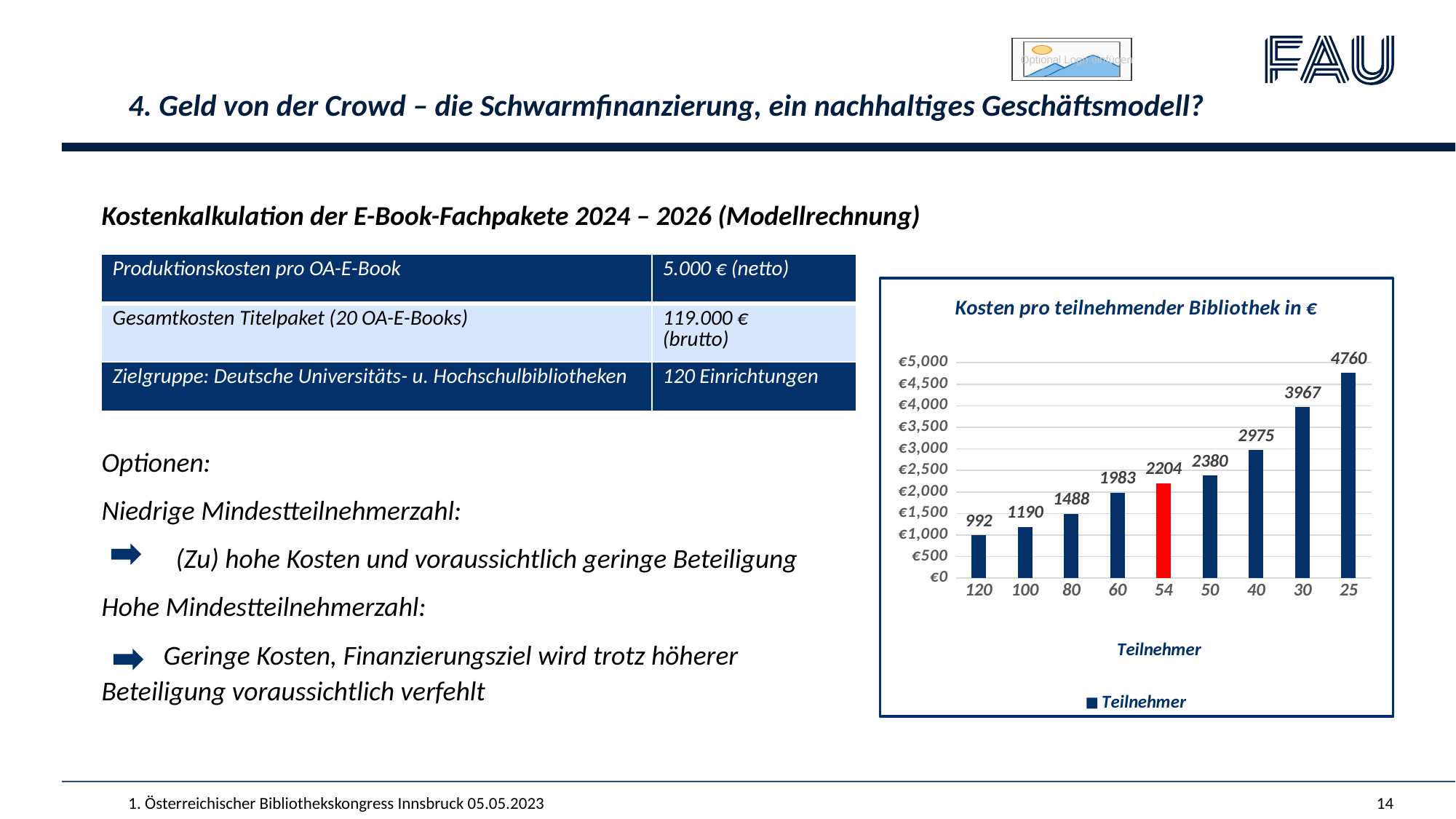
Which participant count has the highest cost per library? 25 What is the cost per participating library when there are 25 participants? 4760 Which participant count has the lowest cost per library? 120 How many participant categories are shown on the x axis? 9 Which bar in the chart is highlighted in red? 54 What is the cost per participating library when there are 54 participants (Teilnehmer)? 2204 What kind of chart is shown on the slide? bar chart Which has a higher cost per library: 60 participants or 80 participants? 60 What is the cost per participating library when there are 120 participants? 992 How many series does the legend list? 1 What is the difference in cost per library between 30 participants and 40 participants? 992 Do the costs per library rise or fall as the number of participants decreases from 120 to 25 along the x axis? rise